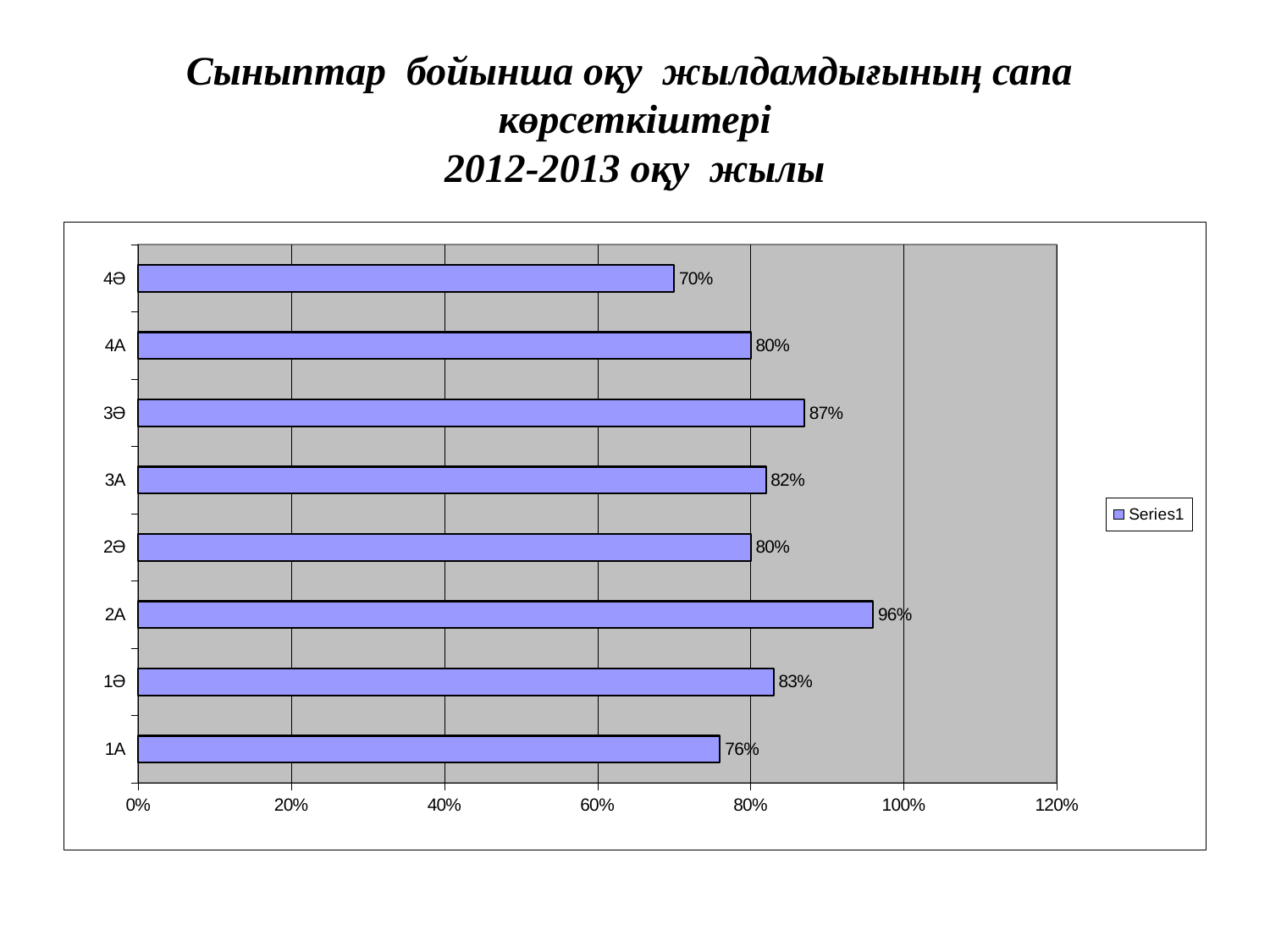
Which is larger, the value for 1Ә or the value for 1A? 1Ә What is the value for class 1A? 76% What is the value for class 3Ә? 87% How many series does the legend list? 1 What is the difference between the values for 3Ә and 3A? 5% What kind of chart is shown on the slide? Bar chart How many classes are shown on the chart? 8 What is the difference between the values for 2A and 4Ә? 26% Which class has the highest value? 2A What is the value for class 4Ә? 70% What is the value for class 2A? 96% Which class has the lowest value? 4Ә